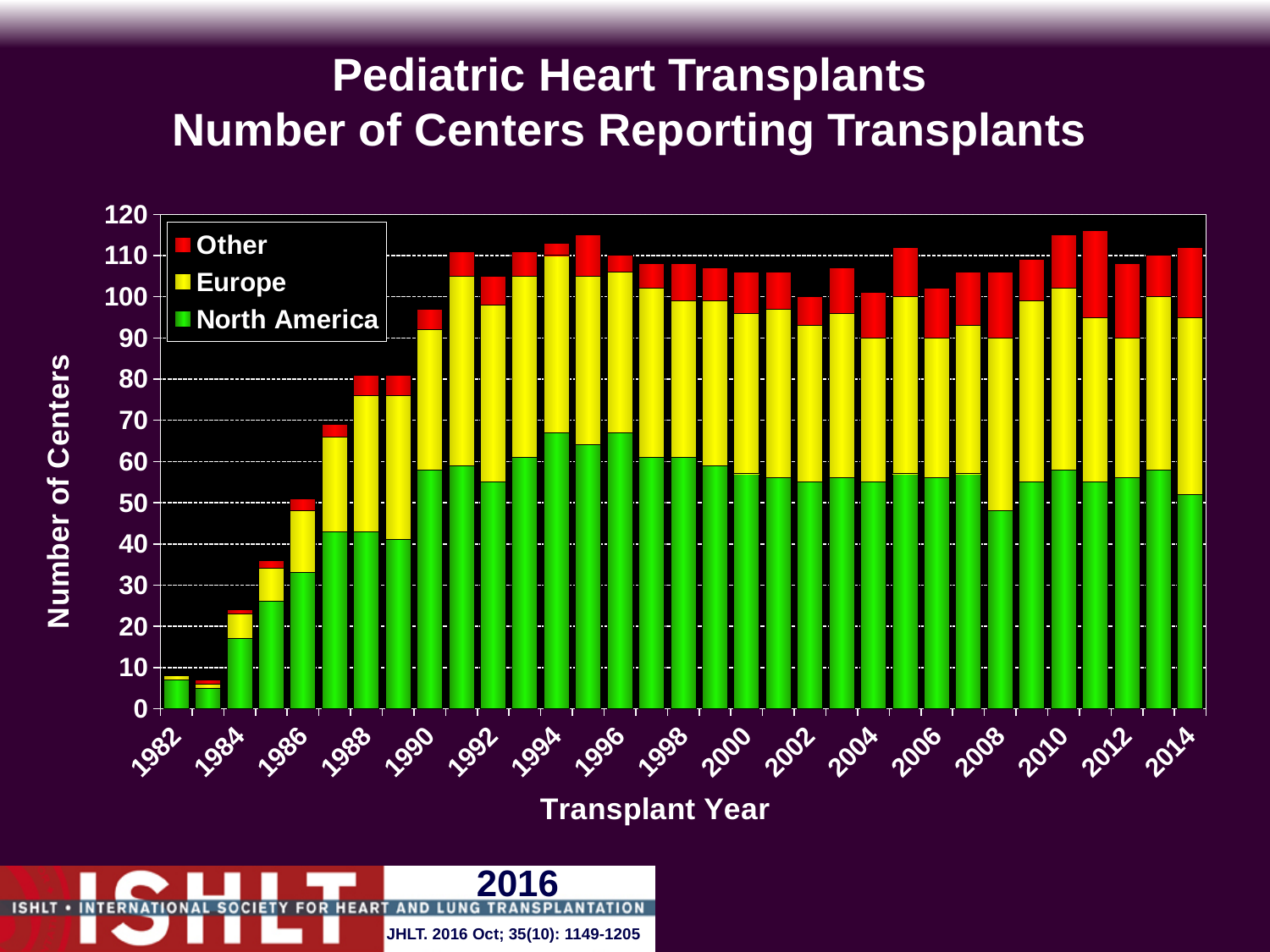
What is the title of the vertical axis? Number of Centers Is the total number of centers for 1982 greater or less than 10? less Is the total number of centers for 1985 greater or less than 30? greater Which series is shown in red in the legend? Other What kind of chart is shown on the slide? stacked bar chart How many series does the legend list? 3 Is the total number of centers for 2011 greater or less than 110? greater Which year has the larger total number of centers, 1985 or 1990? 1990 Which year has the larger North America value, 1982 or 1995? 1995 Do the total bar heights rise or fall from 1982 to 1991? rise